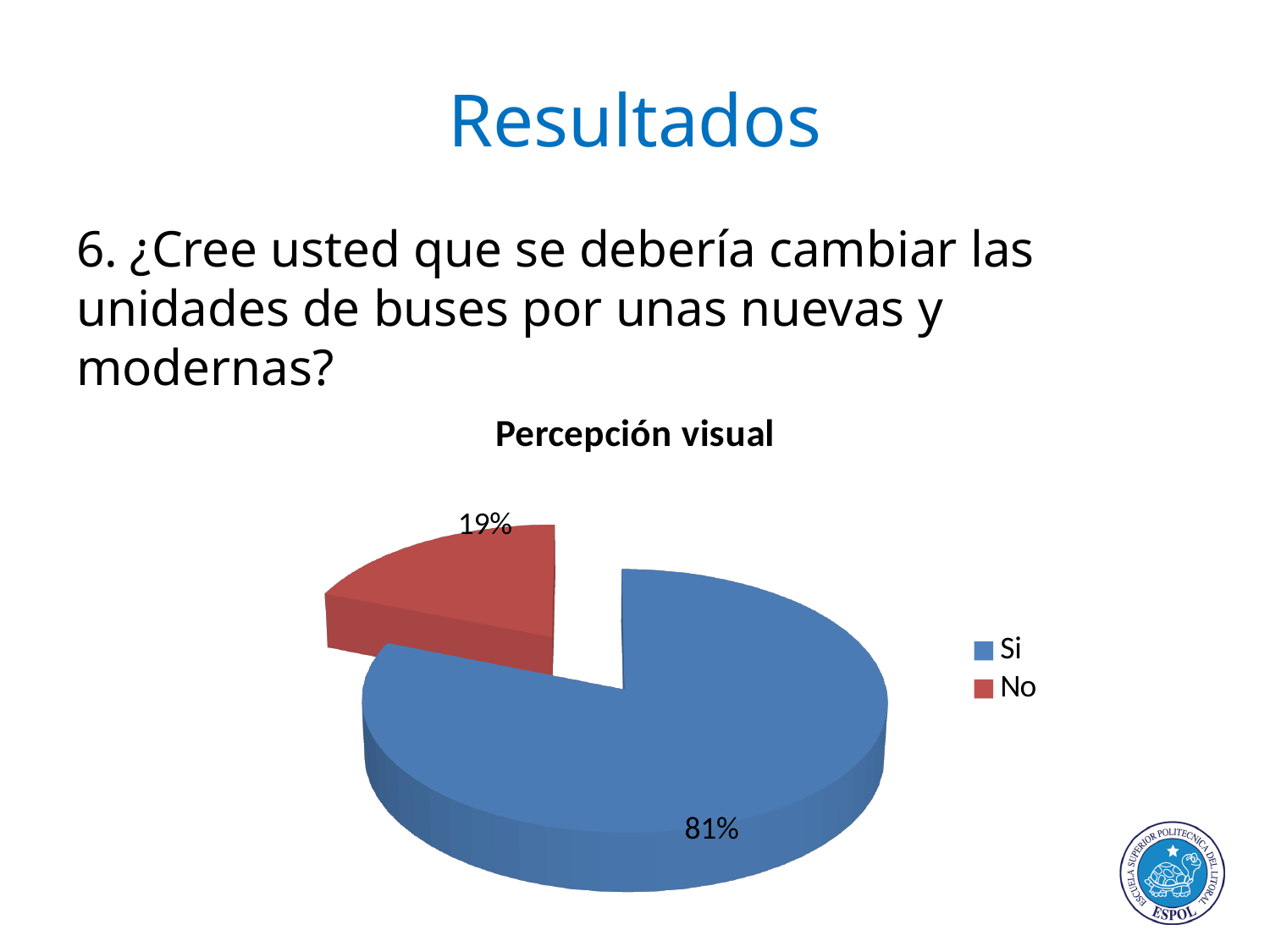
Which category has the smallest share of the pie? No What type of chart is shown on the slide? pie chart What is the difference in percentage points between the "Si" and "No" slices? 62 Which is larger, the share for "Si" or the share for "No"? Si Which category has the largest share of the pie? Si How many slices does the pie chart have? 2 How many categories does the legend list? 2 What percentage of the pie corresponds to "Si"? 81% What is the share of the pie taken by the "Si" slice? 81% What percentage of the pie corresponds to "No"? 19% What colour is the "No" slice? red What is the title of the chart? Percepción visual